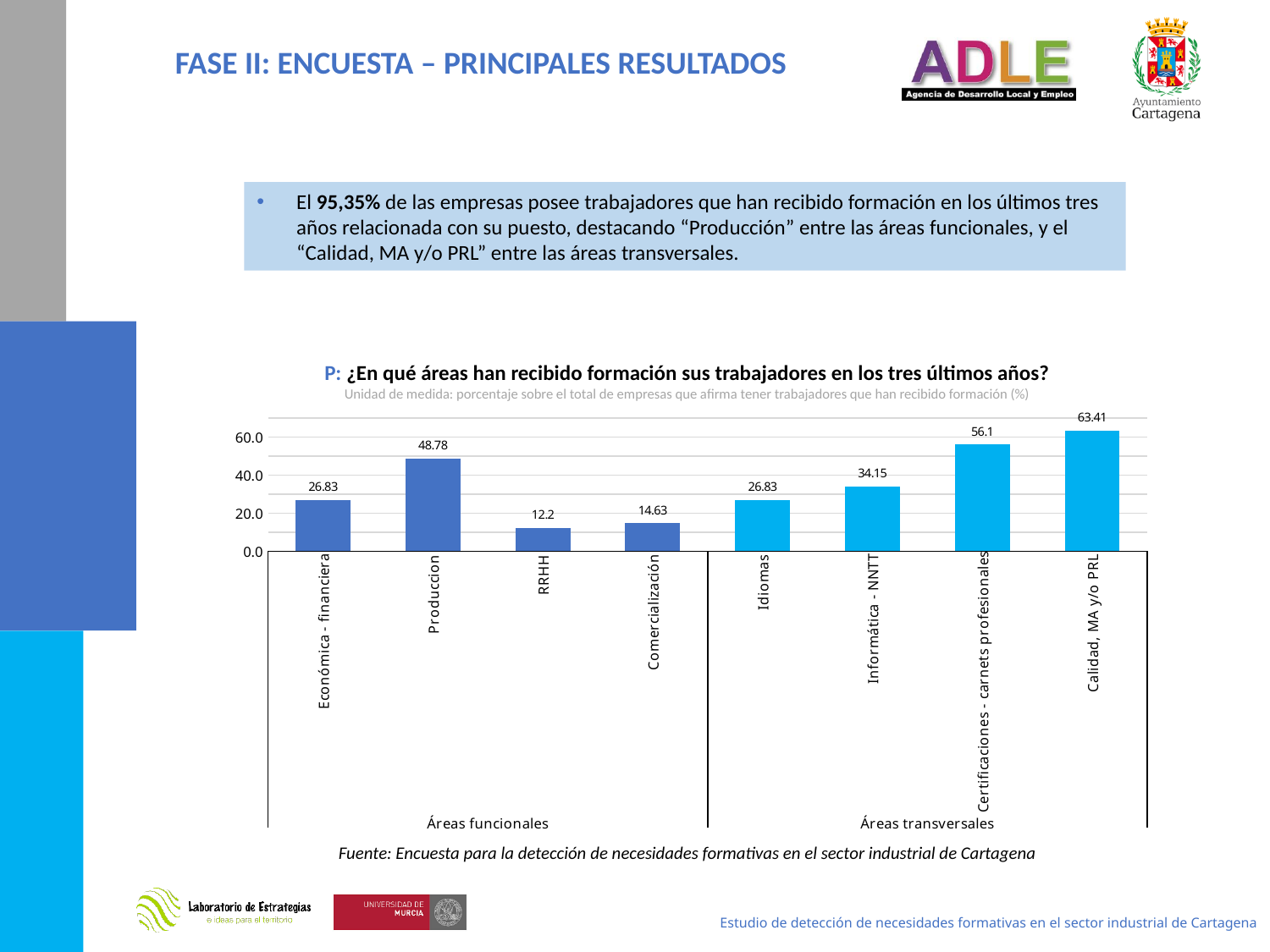
How many categories are plotted in the chart? 8 Which is larger, the value for Produccion or the value for Informática - NNTT? Produccion What value is shown for Produccion? 48.78 What is the difference between the values for Calidad, MA y/o PRL and Certificaciones - carnets profesionales? 7.31 What kind of chart is shown on the slide? bar chart Which category has the lowest value? RRHH Which category has the highest value? Calidad, MA y/o PRL Is the value for Certificaciones - carnets profesionales greater or less than 40.0? greater What value is shown for Calidad, MA y/o PRL? 63.41 What value is shown for RRHH? 12.2 What value is shown for Informática - NNTT? 34.15 What are the two group labels shown beneath the category axis? Áreas funcionales and Áreas transversales